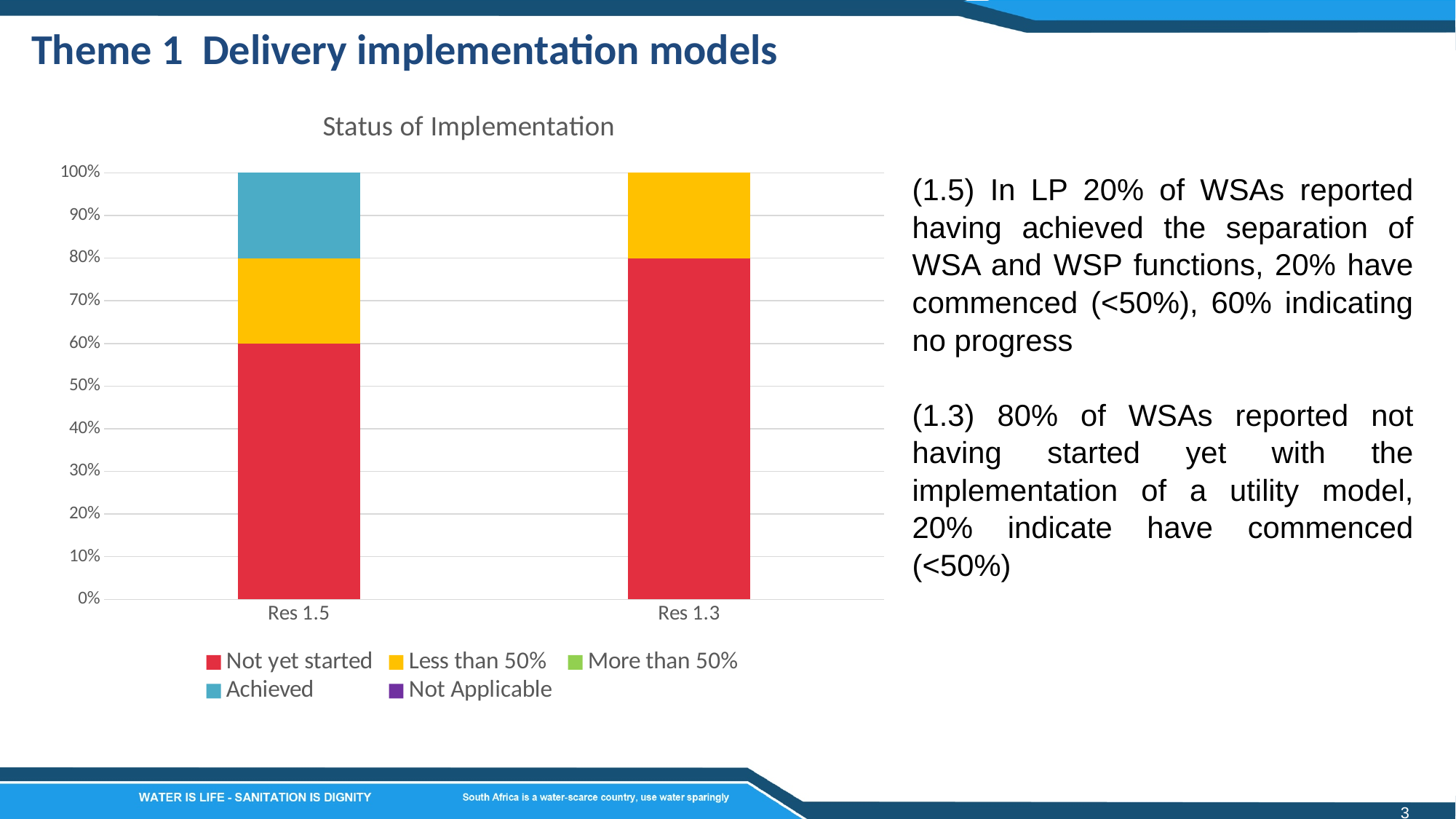
What is the value of the 'Not yet started' segment for Res 1.3? 80% Is the 'Not yet started' value for Res 1.5 greater or less than 50%? greater What is the title of the chart? Status of Implementation How many categories are shown on the x axis of the chart? 2 What is the total height of the stacked bar for Res 1.3? 100% How many series does the chart legend list? 5 What is the value of the 'Less than 50%' segment for Res 1.3? 20% What is the value of the 'Not yet started' segment for Res 1.5? 60% Which category has the larger 'Not yet started' share, Res 1.5 or Res 1.3? Res 1.3 What colour represents the 'Not yet started' series in the chart? Red What kind of chart is shown on the slide? Stacked bar chart What is the value of the 'Achieved' segment for Res 1.5? 20%